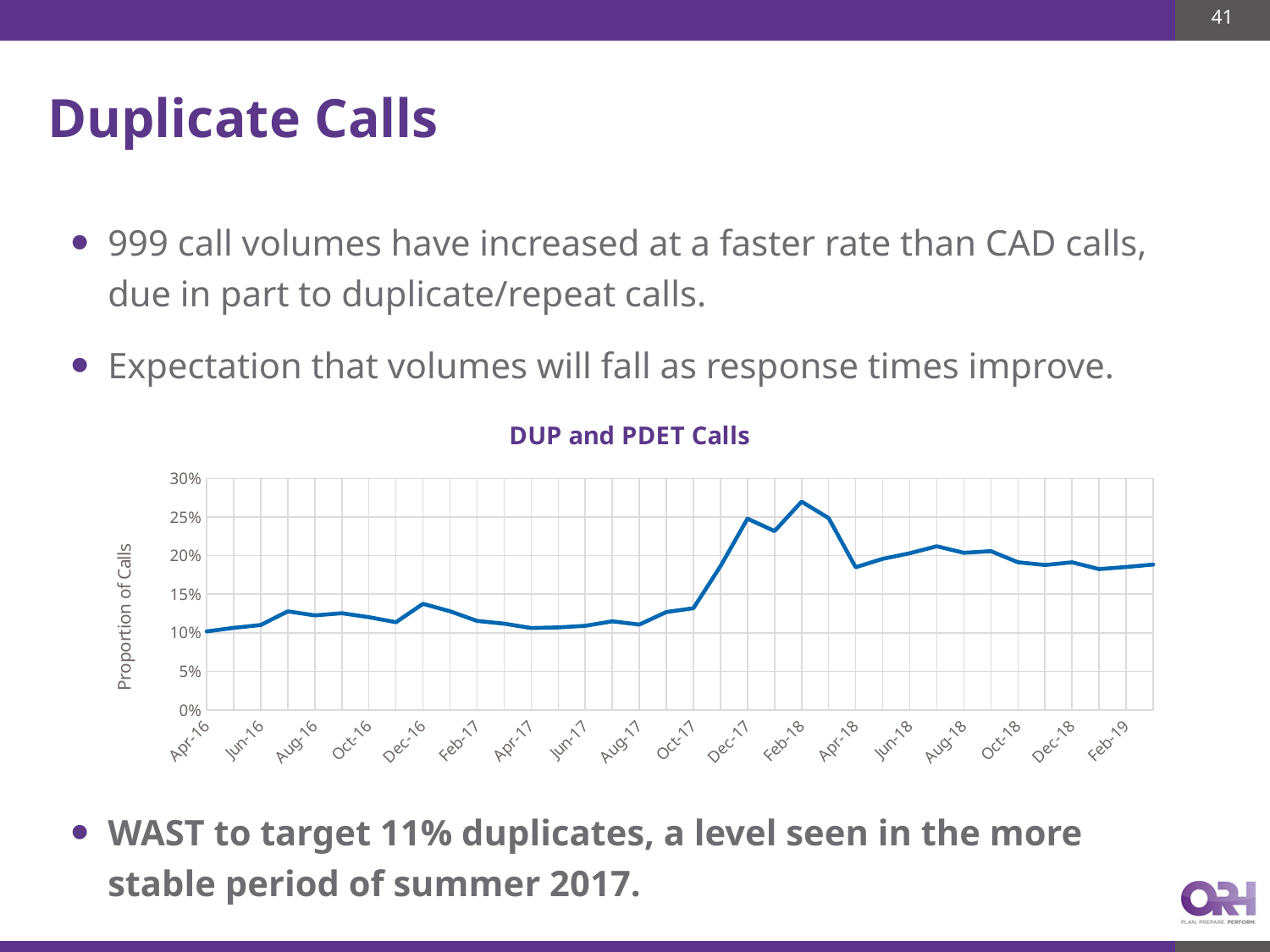
Which has the larger value, Feb-18 or Apr-16? Feb-18 Which has the larger value, Dec-17 or Oct-17? Dec-17 Is the value for Dec-17 greater or less than 20%? greater Is the value for Apr-16 greater or less than 15%? less Is the value for Feb-18 greater or less than 25%? greater Overall, does the proportion of calls rise or fall from Apr-16 to Feb-19? rise In which labelled month does the line reach its highest value? Feb-18 What kind of chart is shown on the slide? line chart What is the title of the chart? DUP and PDET Calls What is the label on the vertical axis of the chart? Proportion of Calls